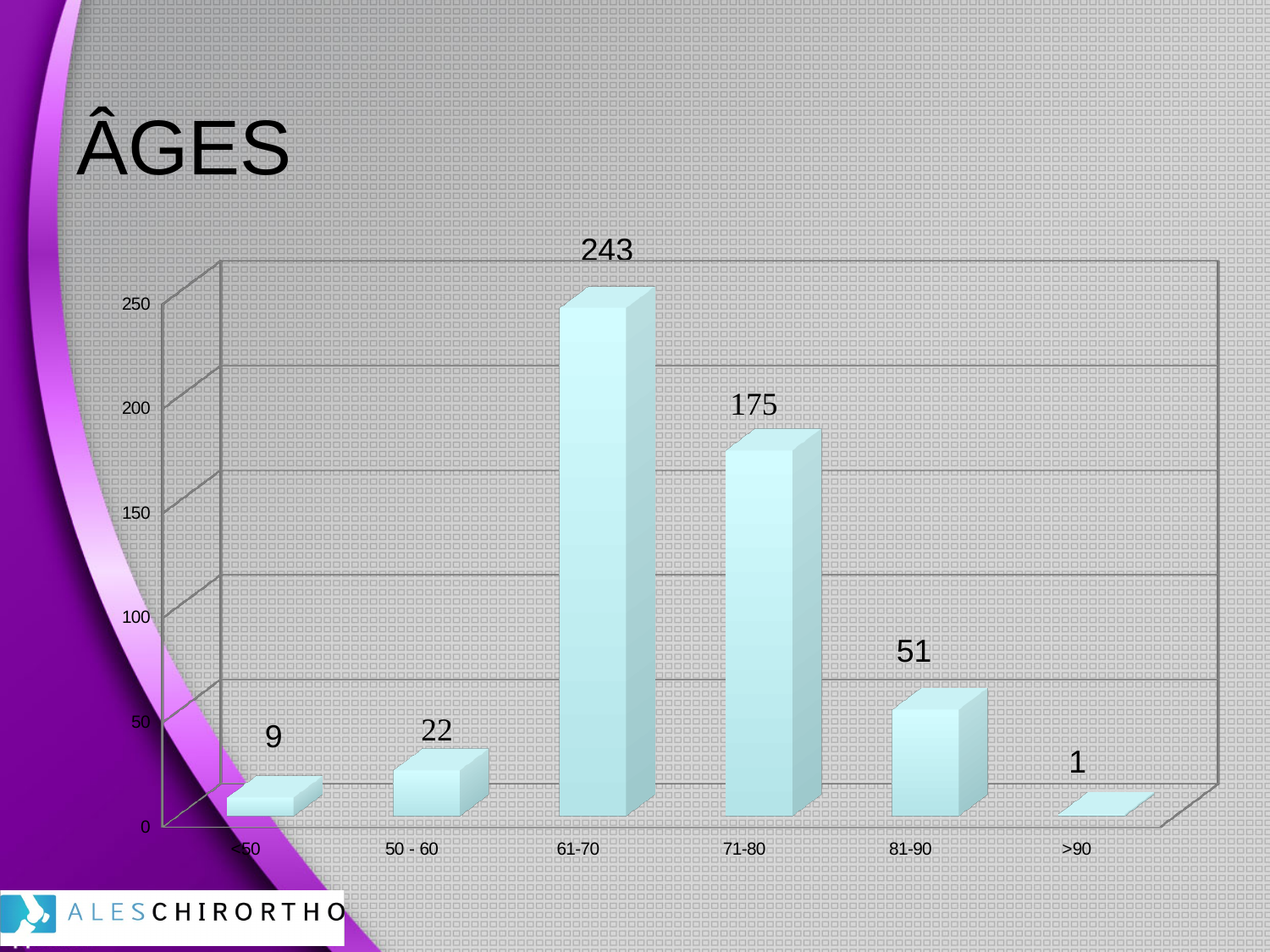
What kind of chart is shown on the slide? bar chart What is the value for the <50 age group? 9 What is the title of the slide? ÂGES What is the difference between the values for 61-70 and 71-80? 68 What is the value for the 61-70 age group? 243 What is the value for the 50 - 60 age group? 22 How many age groups are shown on the chart? 6 Is the value for 71-80 greater or less than 150? greater Which age group has the lowest value? >90 Which is larger, the value for 71-80 or the value for 81-90? 71-80 Which age group has the highest value? 61-70 What is the value for the 81-90 age group? 51